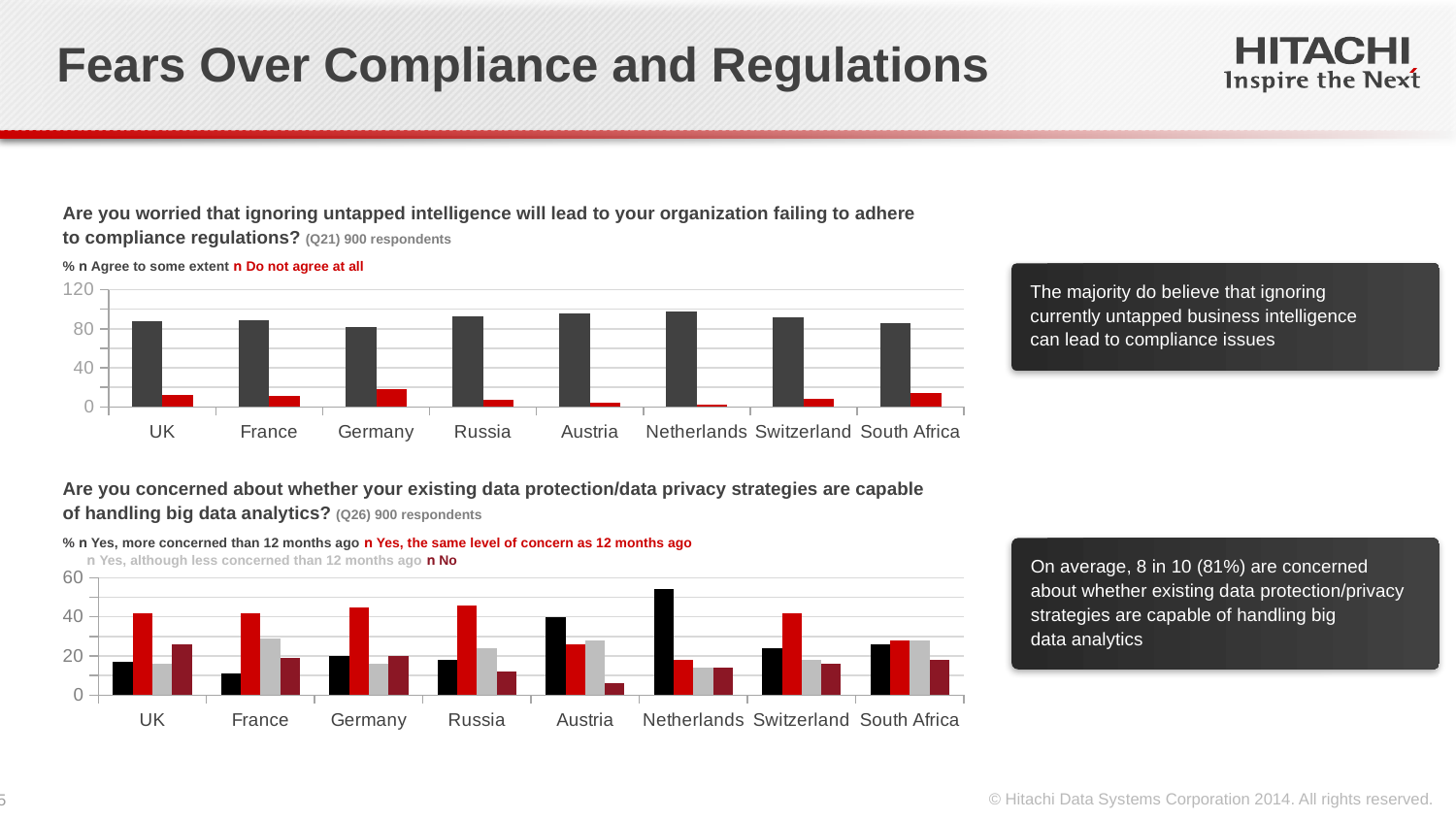
In the bottom chart (Q26), which country has the highest 'Yes, more concerned than 12 months ago' value? Netherlands In the top chart (Q21), which is larger for the UK: 'Agree to some extent' or 'Do not agree at all'? Agree to some extent In the bottom chart (Q26), is the 'No' value for Austria greater or less than 20? less What kind of chart is the top chart (Q21) on the slide? Bar chart In the top chart (Q21), which country has the highest 'Do not agree at all' value? Germany How many countries are shown on the x axis of the top chart (Q21)? 8 In the top chart (Q21), is the 'Agree to some extent' value for Austria greater or less than 80? greater In the top chart (Q21), which country has the lowest 'Agree to some extent' value? Germany How many series does the legend of the top chart (Q21) list? 2 In the bottom chart (Q26), is the 'Yes, more concerned than 12 months ago' value for the Netherlands greater or less than 40? greater How many series does the legend of the bottom chart (Q26) list? 4